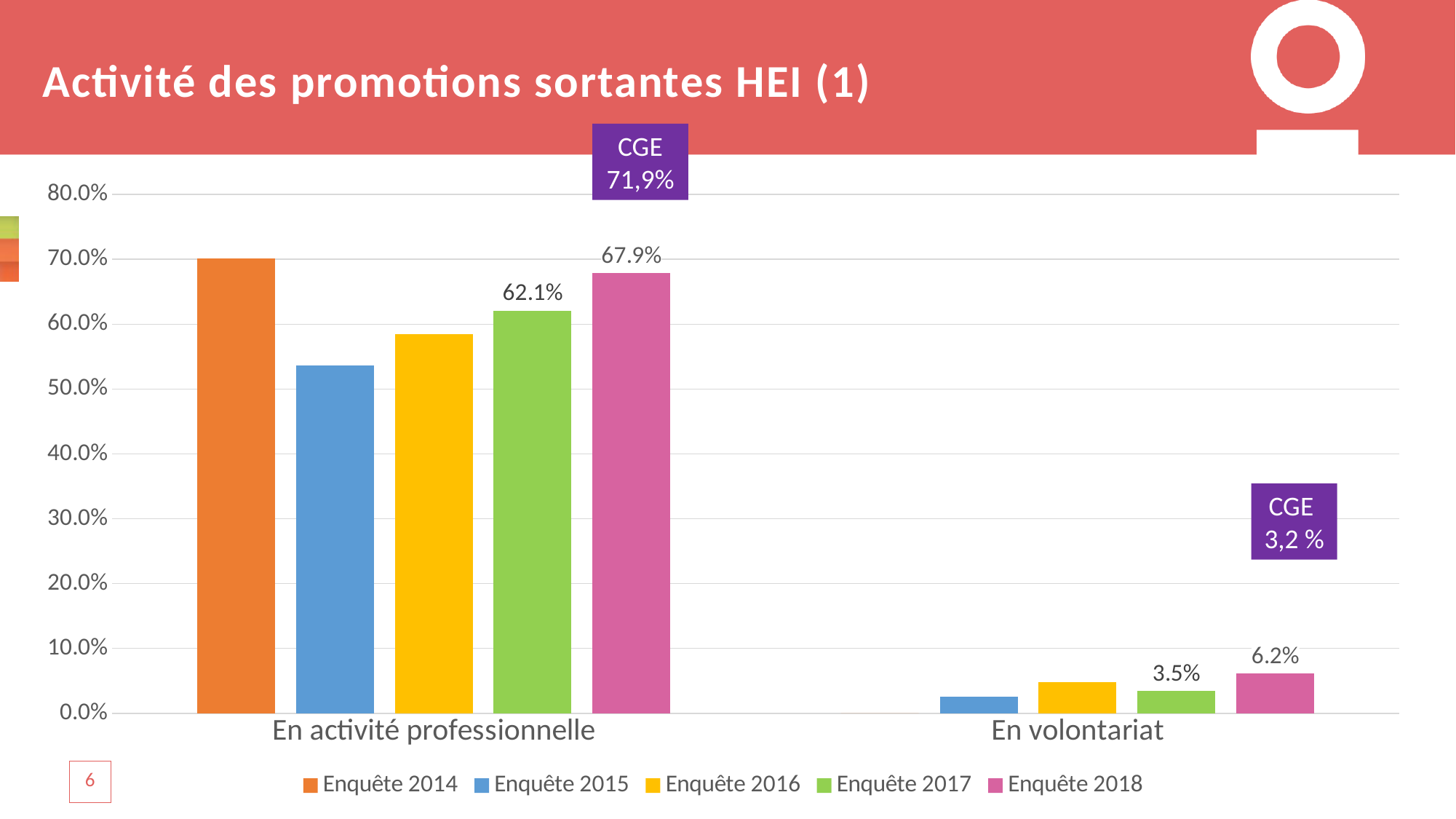
Which survey has the lowest bar in the En activité professionnelle category? Enquête 2015 Is the value for Enquête 2015 in En activité professionnelle greater or less than 60.0%? less What is the value for Enquête 2018 in the En volontariat category? 6.2% What is the value for Enquête 2018 in the En activité professionnelle category? 67.9% What is the value for Enquête 2017 in the En activité professionnelle category? 62.1% What is the value for Enquête 2017 in the En volontariat category? 3.5% What is the difference between the Enquête 2018 and Enquête 2017 values for En activité professionnelle? 5.8 percentage points For En volontariat, which is larger: Enquête 2017 or Enquête 2018? Enquête 2018 How many categories are shown on the x axis? 2 What is the difference between the Enquête 2018 and Enquête 2017 values for En volontariat? 2.7 percentage points What kind of chart is shown on the slide? Bar chart How many series does the legend list? 5